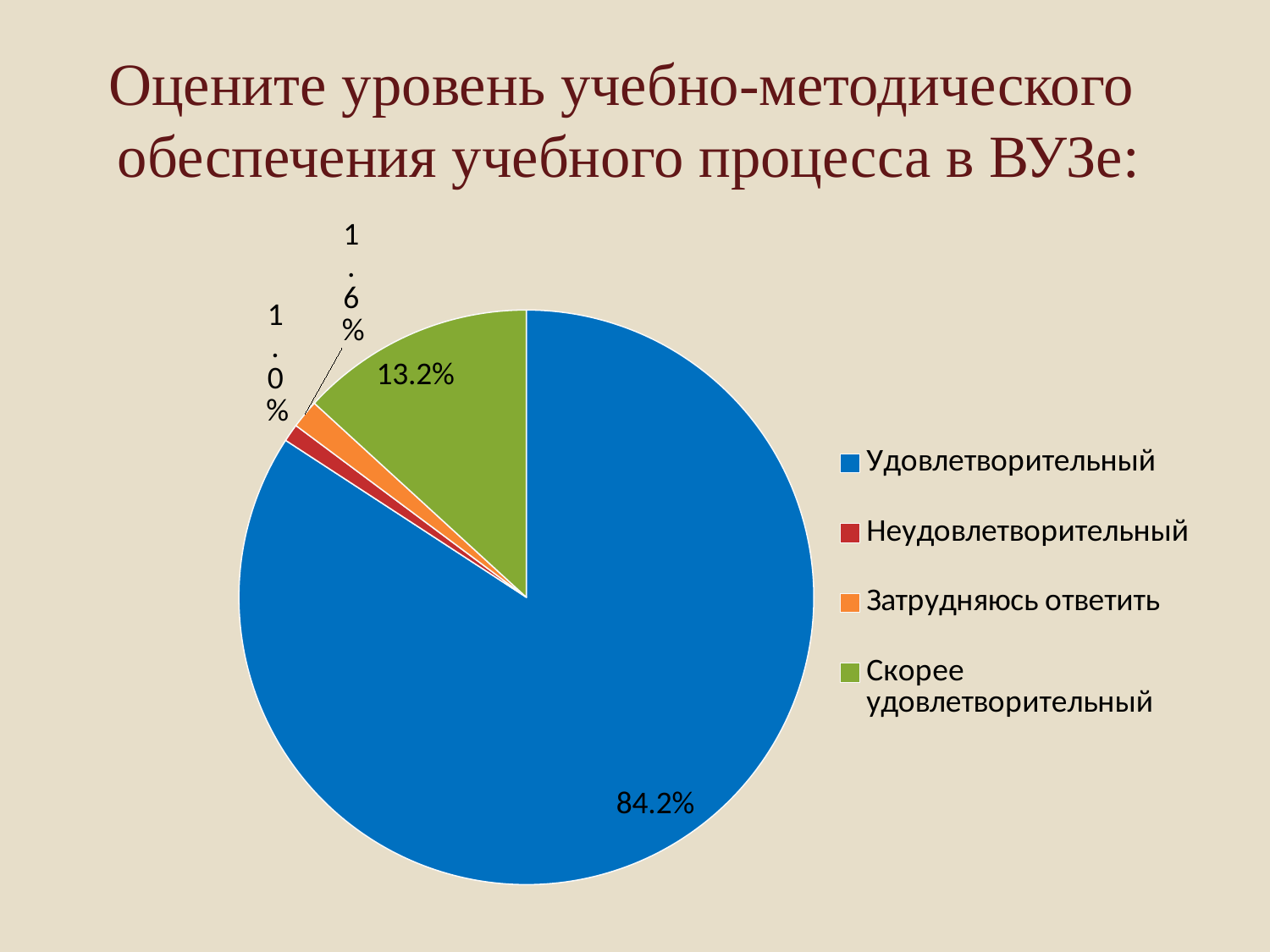
Which category has the largest slice of the pie? Удовлетворительный Which is larger, the share of Скорее удовлетворительный or the share of Затрудняюсь ответить? Скорее удовлетворительный What share of the pie does Скорее удовлетворительный have? 13.2% What colour is the slice for Скорее удовлетворительный? green How many categories does the pie chart show? 4 What kind of chart is shown on the slide? pie chart What share of the pie does Неудовлетворительный have? 1.0% What is the difference between the shares of Удовлетворительный and Скорее удовлетворительный? 71.0% What share of the pie does Затрудняюсь ответить have? 1.6% Which category has the smallest slice of the pie? Неудовлетворительный What is the combined share of Неудовлетворительный and Затрудняюсь ответить? 2.6%